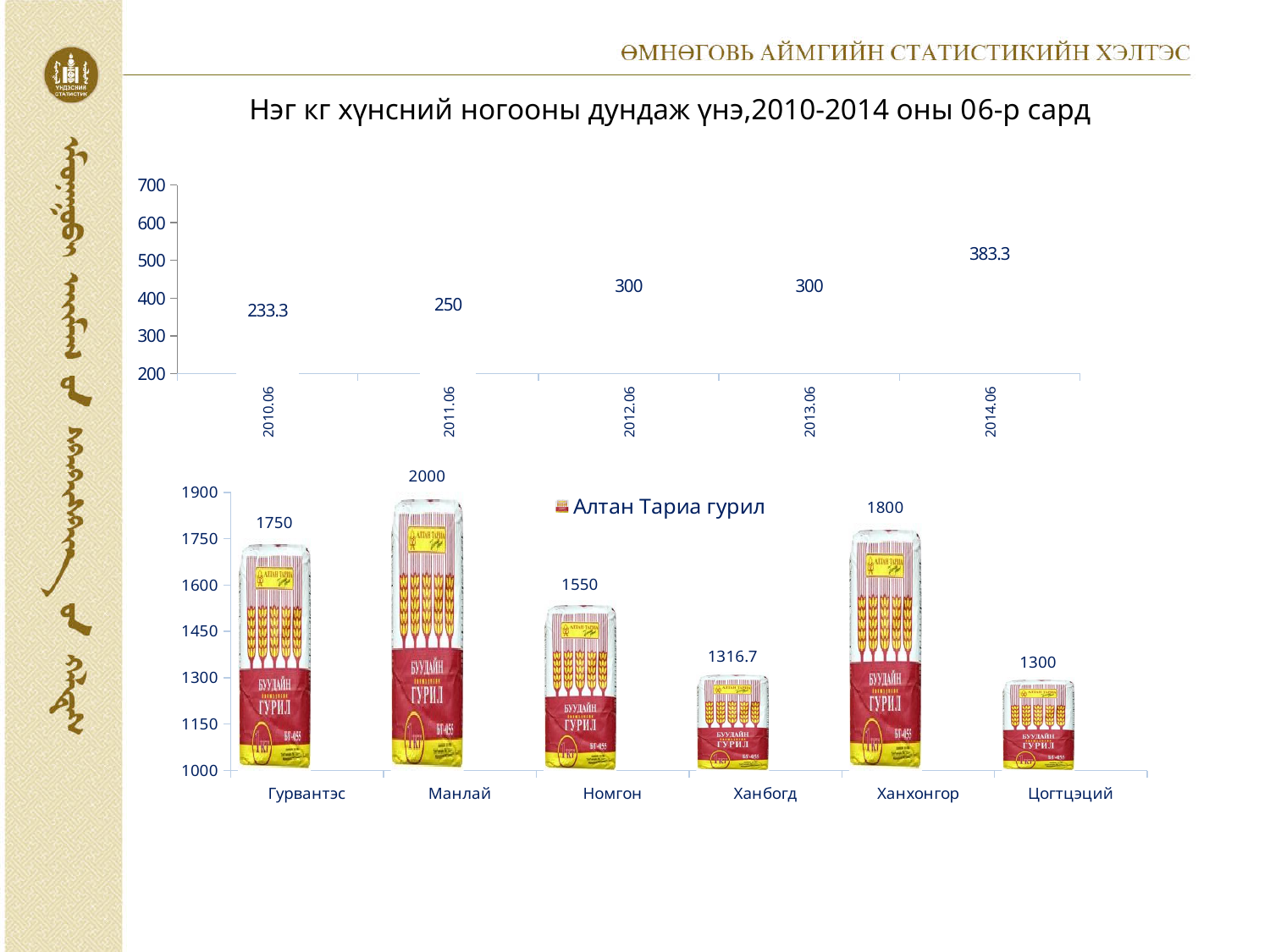
In the bottom chart (Алтан Тариа гурил), which category has the lowest value? Цогтцэций In the top chart (Нэг кг хүнсний ногооны дундаж үнэ), what is the difference between the values for 2014.06 and 2010.06? 150 In the top chart (Нэг кг хүнсний ногооны дундаж үнэ), which period has the highest value? 2014.06 In the bottom chart (Алтан Тариа гурил), what is the value for Манлай? 2000 In the top chart (Нэг кг хүнсний ногооны дундаж үнэ), do the values rise or fall from 2010.06 to 2014.06? rise In the top chart (Нэг кг хүнсний ногооны дундаж үнэ), what is the value for 2014.06? 383.3 In the bottom chart (Алтан Тариа гурил), what is the value for Ханбогд? 1316.7 In the bottom chart (Алтан Тариа гурил), what is the difference between the values for Манлай and Номгон? 450 In the bottom chart (Алтан Тариа гурил), which is larger, the value for Гурвантэс or the value for Ханхонгор? Ханхонгор What kind of chart is the bottom chart (Алтан Тариа гурил)? bar chart In the top chart (Нэг кг хүнсний ногооны дундаж үнэ), what is the value for 2010.06? 233.3 In the top chart (Нэг кг хүнсний ногооны дундаж үнэ), how many periods are shown on the x axis? 5